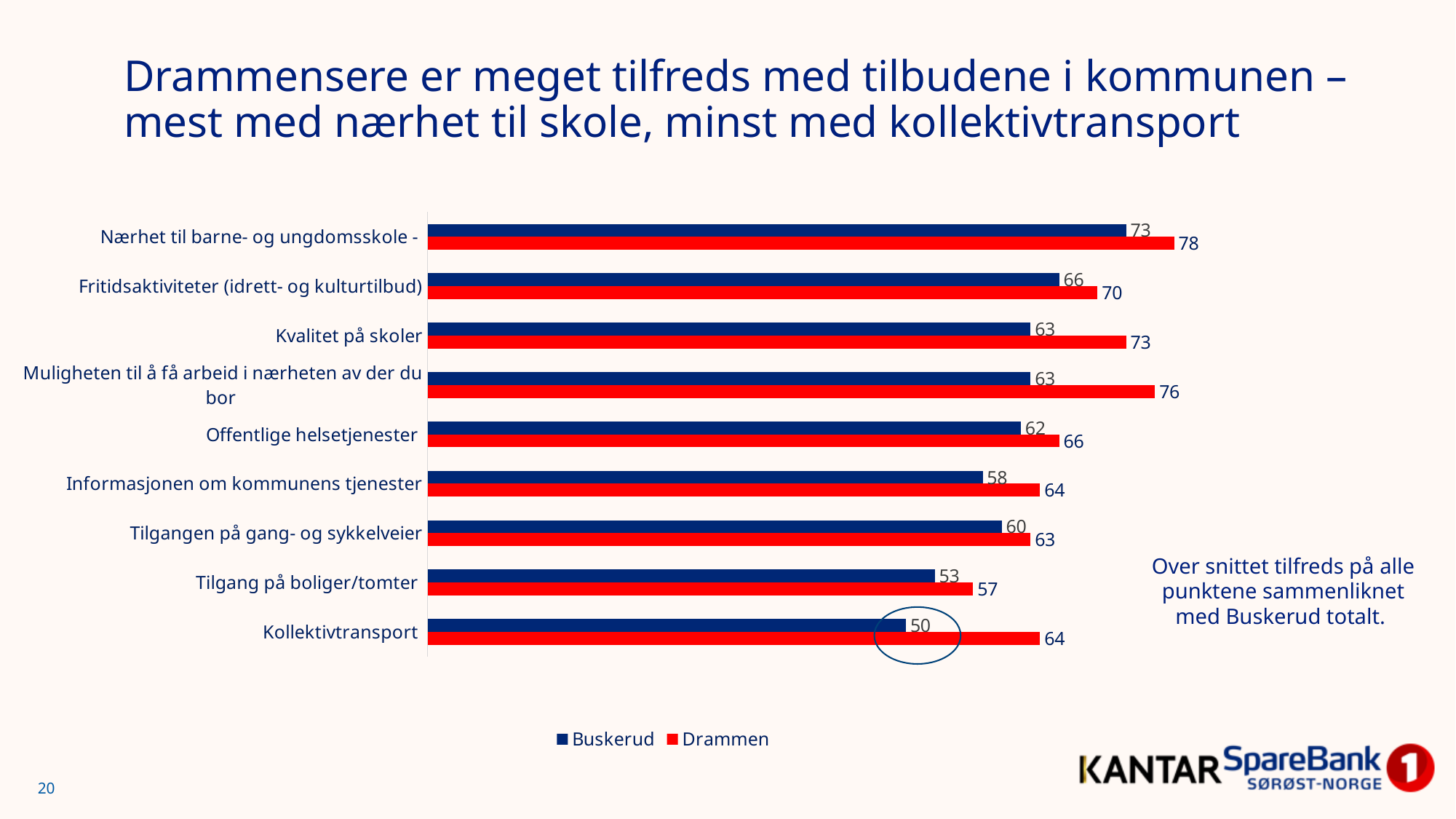
How many categories are shown in the chart? 9 What is the Drammen value for Muligheten til å få arbeid i nærheten av der du bor? 76 How many series does the legend list? 2 Which series is shown in red in the legend? Drammen What is the Buskerud value for Kvalitet på skoler? 63 Which category has the lowest Buskerud value? Kollektivtransport What is the difference between the Drammen values for Nærhet til barne- og ungdomsskole - and Tilgang på boliger/tomter? 21 Which category has the highest Drammen value? Nærhet til barne- og ungdomsskole - What is the difference between the Drammen and Buskerud values for Kollektivtransport? 14 Which is larger for Offentlige helsetjenester, the Buskerud value or the Drammen value? Drammen What kind of chart is shown on the slide? Bar chart What is the Drammen value for Kollektivtransport? 64